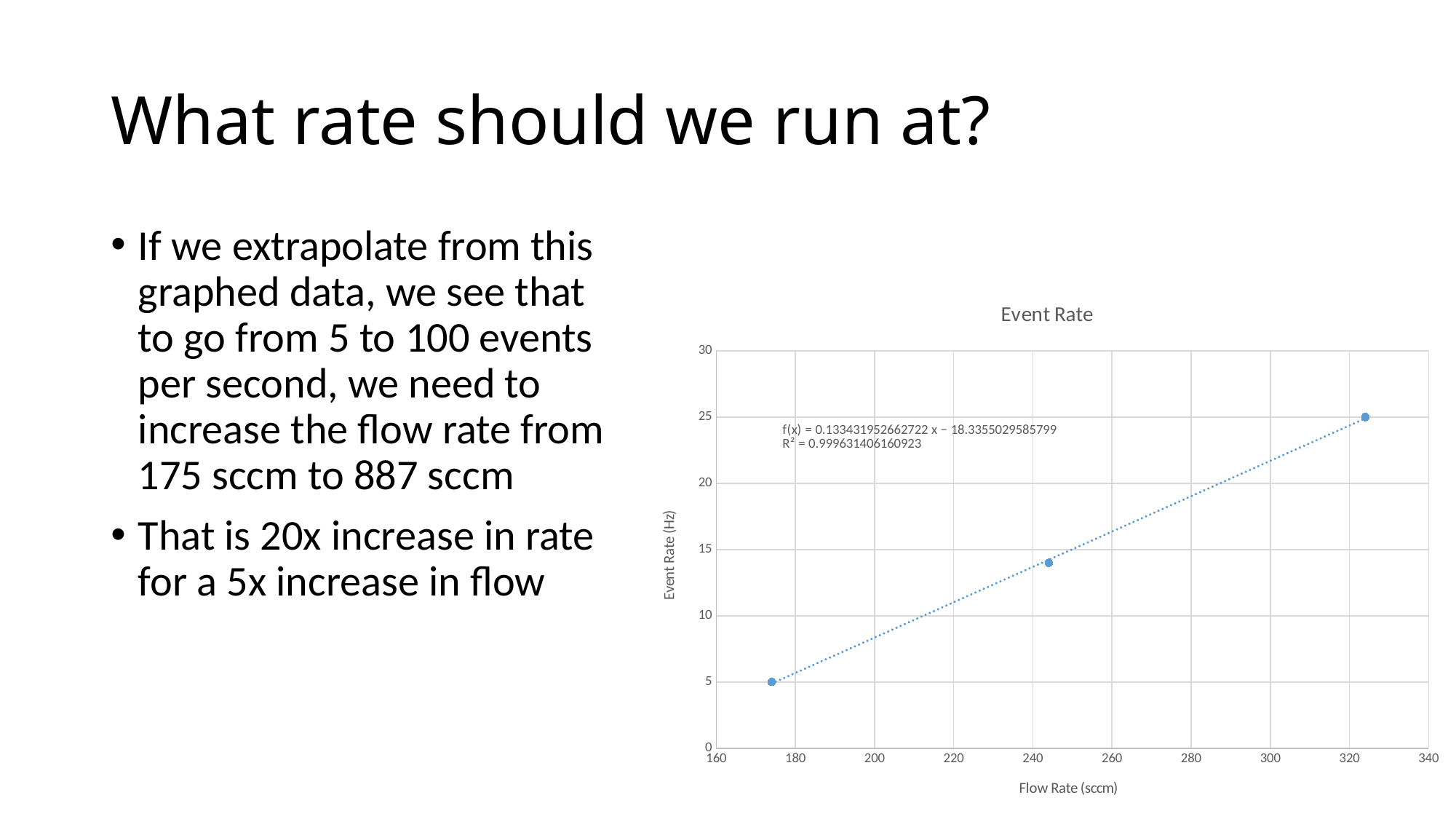
Is the event rate of the point at the highest flow rate greater or less than 20 Hz? greater Is the event rate of the middle data point (near 240 sccm) greater or less than 10 Hz? greater Which data point has the highest event rate: the one at the lowest, middle, or highest flow rate? the one at the highest flow rate What R² value is printed on the chart? 0.999631406160923 Is the event rate of the middle data point (near 240 sccm) greater or less than 15 Hz? less Does the event rate rise or fall as the flow rate increases along the x axis? rise What is the event rate (Hz) of the data point at the lowest flow rate? 5 Which point has the higher event rate: the one near 180 sccm or the one near 240 sccm? the one near 240 sccm What kind of chart is shown on the slide? scatter chart How many data points are plotted in the Event Rate chart? 3 What is the title of the chart? Event Rate